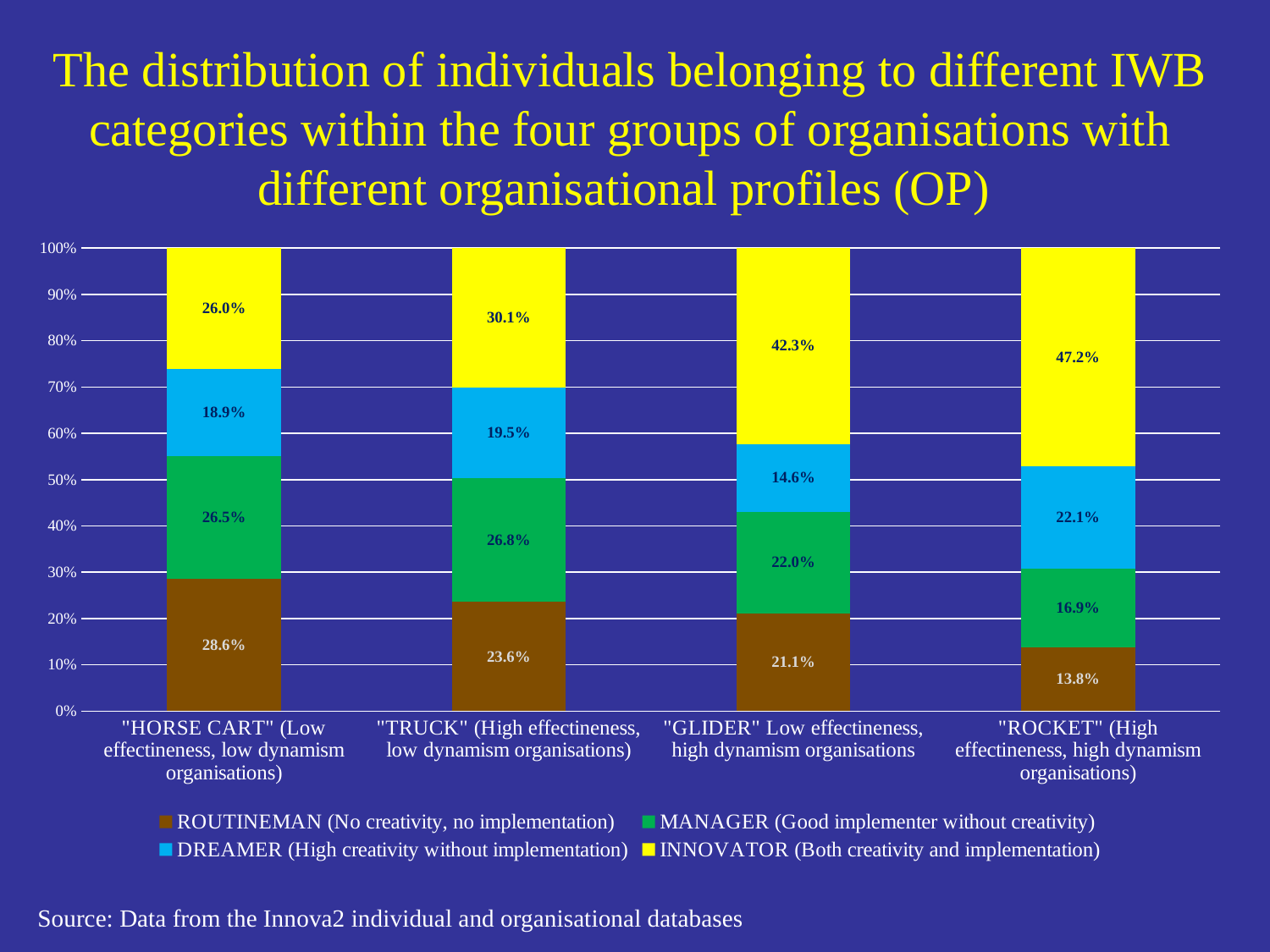
What is the ROUTINEMAN share in "HORSE CART" organisations? 28.6% Which is larger: the DREAMER share in "TRUCK" or in "ROCKET" organisations? "ROCKET" What is the DREAMER percentage for "GLIDER" organisations? 14.6% Does the ROUTINEMAN share rise or fall moving from "HORSE CART" to "ROCKET" along the x axis? Fall What percentage of individuals in "ROCKET" organisations are INNOVATORs? 47.2% What is the MANAGER percentage for "TRUCK" organisations? 26.8% How many IWB categories does the legend list? 4 How many organisation groups are shown on the x axis? 4 What type of chart is shown on the slide? Stacked bar chart Which organisation group has the lowest ROUTINEMAN share? "ROCKET" What is the difference between the INNOVATOR share in "ROCKET" and in "HORSE CART" organisations? 21.2% Which organisation group has the highest INNOVATOR share? "ROCKET"